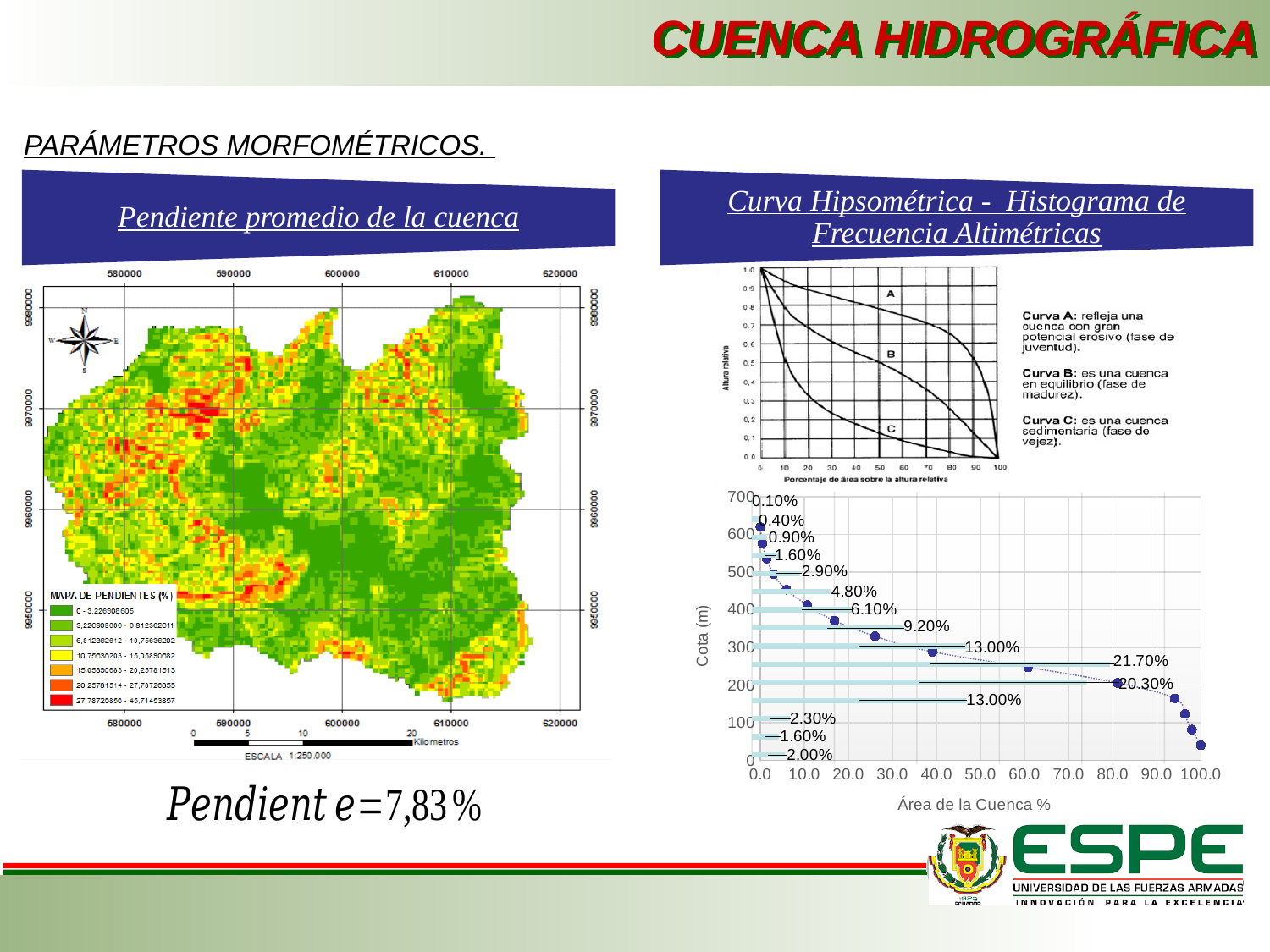
In the reference hypsometric diagram above the histogram, how many labelled curves are drawn? 3 In the hypsometric curve / altimetric frequency histogram chart, what is the difference between the 13.00% label and the 9.20% label? 3.80% In the hypsometric curve / altimetric frequency histogram chart, what is the difference between the 21.70% label and the 20.30% label? 1.40% In the hypsometric curve / altimetric frequency histogram chart, what is the smallest percentage data label shown? 0.10% In the hypsometric curve / altimetric frequency histogram chart, what is the title of the vertical axis? Cota (m) In the hypsometric curve / altimetric frequency histogram chart, how many percentage data labels are printed? 15 In the hypsometric curve / altimetric frequency histogram chart, what is the largest percentage data label shown? 21.70% In the hypsometric curve / altimetric frequency histogram chart, what kind of chart is used for the percentage values? bar chart In the hypsometric curve / altimetric frequency histogram chart, what is the highest tick value on the vertical axis? 700 In the hypsometric curve / altimetric frequency histogram chart, what is the highest tick value on the horizontal axis? 100.0 In the hypsometric curve / altimetric frequency histogram chart, which is larger, the 21.70% value or the 20.30% value? 21.70% In the hypsometric curve / altimetric frequency histogram chart, what is the title of the horizontal axis? Área de la Cuenca %